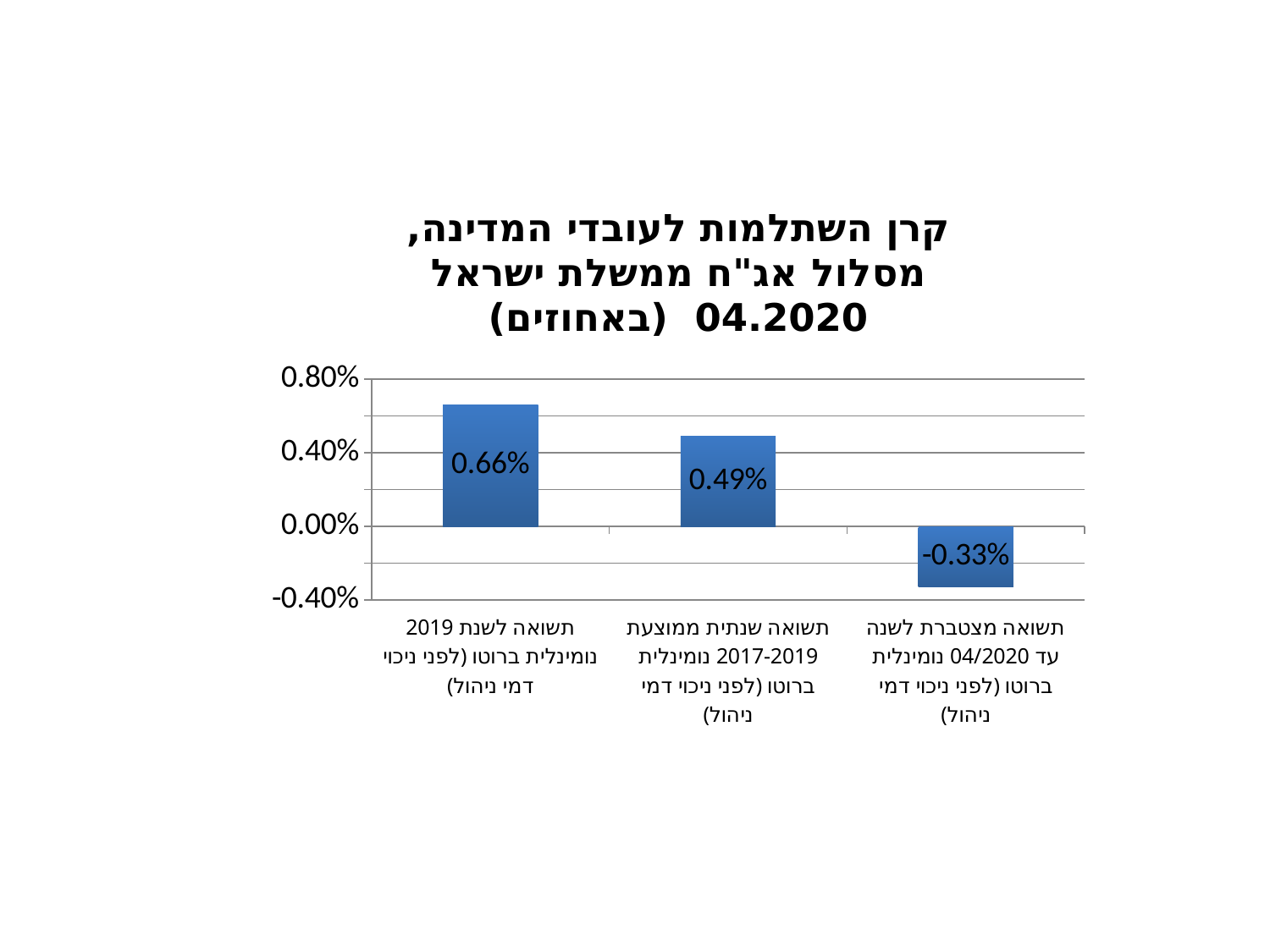
Is the value for the 2019 return greater or less than 0.40%? greater Which category has the lowest value in the chart? תשואה מצטברת לשנה עד 04/2020 נומינלית ברוטו (לפני ניכוי דמי ניהול) Which is larger: the 2017-2019 average annual return or the cumulative return to 04/2020? תשואה שנתית ממוצעת 2017-2019 נומינלית ברוטו (לפני ניכוי דמי ניהול) What is the difference between the 2019 return (0.66%) and the 2017-2019 average annual return (0.49%)? 0.17% What type of chart is shown on the slide? bar chart What is the value of the bar for תשואה מצטברת לשנה עד 04/2020 נומינלית ברוטו (לפני ניכוי דמי ניהול)? -0.33% Which category has the highest value in the chart? תשואה לשנת 2019 נומינלית ברוטו (לפני ניכוי דמי ניהול) What is the difference between the 2019 return (0.66%) and the cumulative return to 04/2020 (-0.33%)? 0.99% What is the value of the bar for תשואה שנתית ממוצעת 2017-2019 נומינלית ברוטו (לפני ניכוי דמי ניהול)? 0.49% Do the values rise or fall from left to right across the chart? fall How many categories (bars) are shown in the chart? 3 What is the value of the bar for תשואה לשנת 2019 נומינלית ברוטו (לפני ניכוי דמי ניהול)? 0.66%